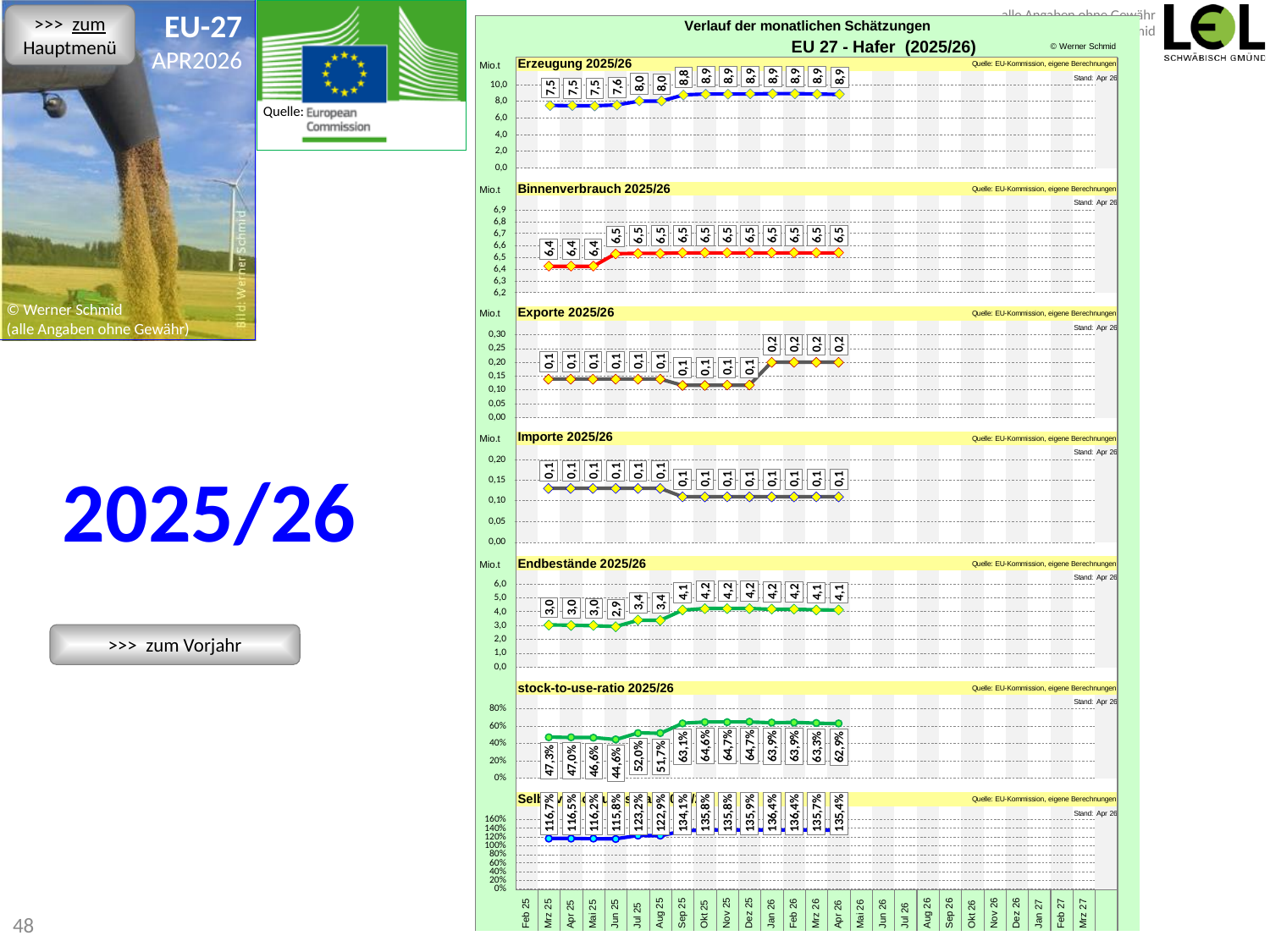
In the 'stock-to-use-ratio 2025/26' chart, what is the value for Apr 26? 62,9% In the 'stock-to-use-ratio 2025/26' chart, what is the lowest value shown? 44,6% In the 'Erzeugung 2025/26' chart, what is the value for Mrz 25? 7,5 In the 'Erzeugung 2025/26' chart, what is the value for Apr 26? 8,9 In the 'Endbestände 2025/26' chart, what is the highest value shown? 4,2 What kind of charts are shown on the slide? line charts In the 'Endbestände 2025/26' chart, what is the lowest value shown? 2,9 In the 'Exporte 2025/26' chart, what is the value for Apr 26? 0,2 In the 'Erzeugung 2025/26' chart, what is the difference between the Apr 26 value and the Mrz 25 value? 1,4 In the 'Erzeugung 2025/26' chart, do the values rise or fall from Mrz 25 to Apr 26? rise In the 'Importe 2025/26' chart, what is the value for Apr 26? 0,1 In the 'Binnenverbrauch 2025/26' chart, what is the value for Apr 26? 6,5